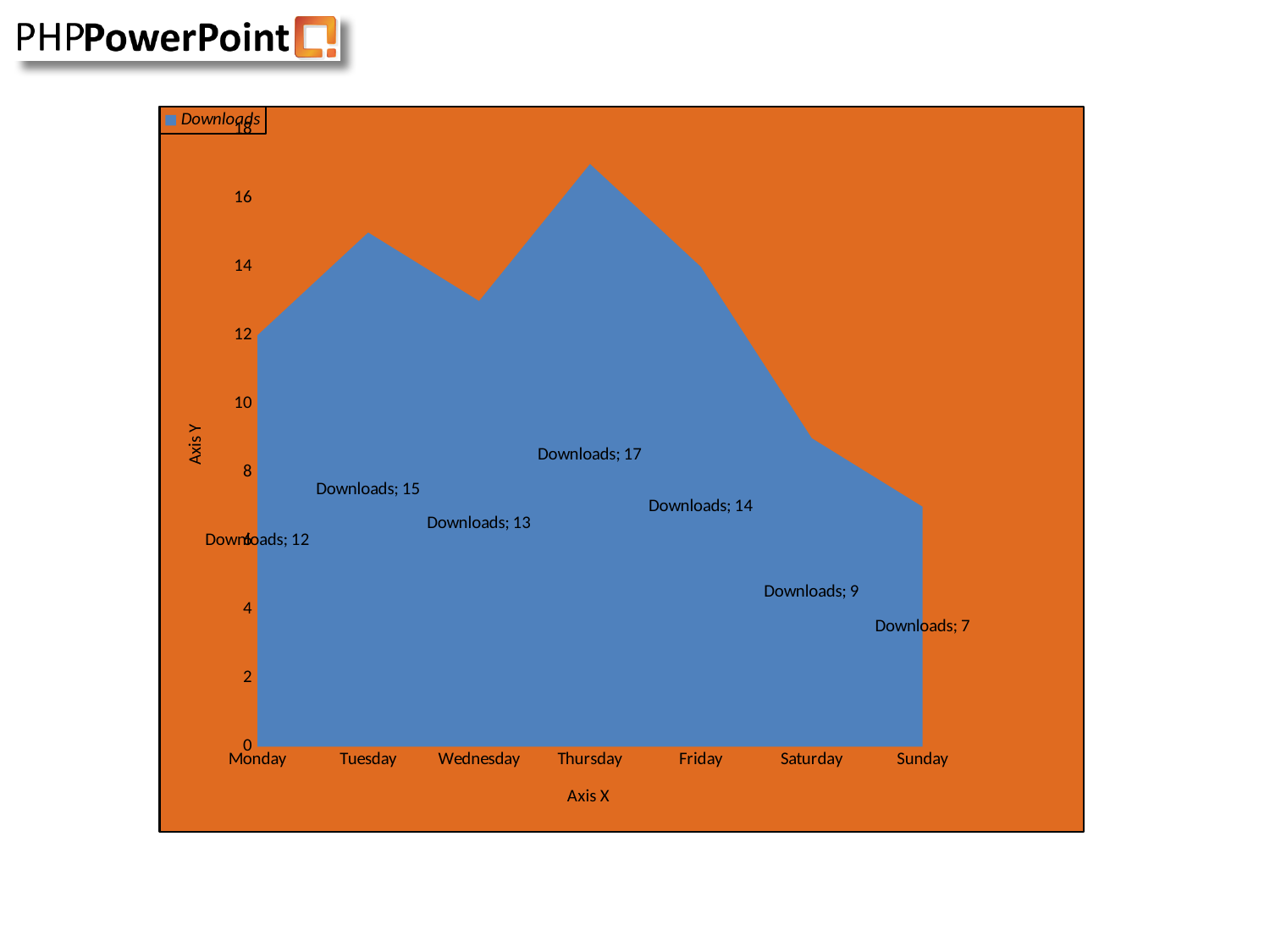
Which day has the highest Downloads value? Thursday What is the Downloads value for Thursday? 17 How many series does the legend list? 1 What is the Downloads value for Tuesday? 15 What is the title of the vertical axis? Axis Y What kind of chart is shown on the slide? area chart What is the Downloads value for Sunday? 7 Which day has the lowest Downloads value? Sunday How many days are shown on the x axis? 7 Which has a larger Downloads value, Tuesday or Friday? Tuesday Is the Downloads value for Saturday greater or less than 10? less What is the difference between the Downloads values for Thursday and Sunday? 10